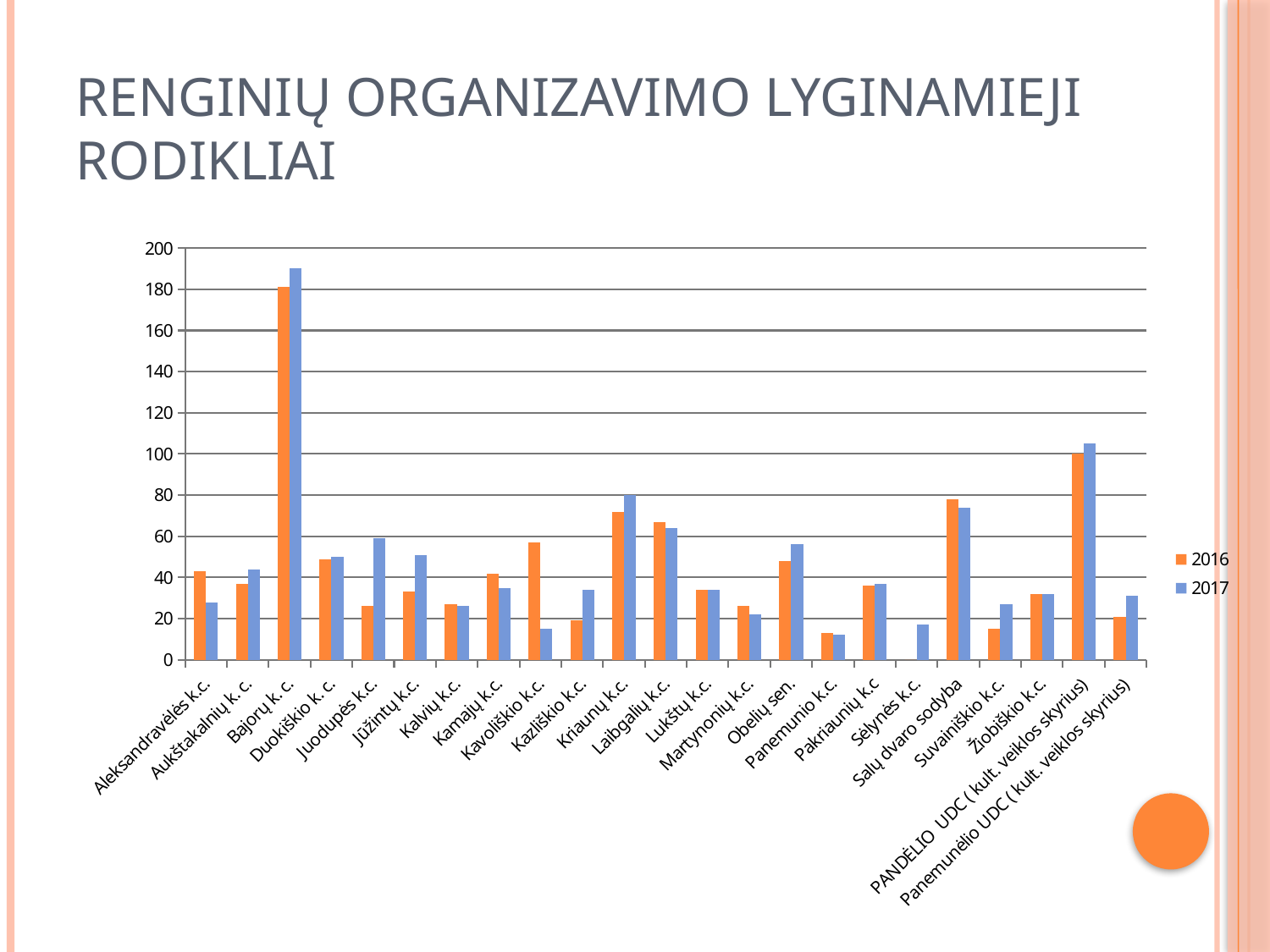
Which category has the highest value for 2016? Bajorų k.c. For Kavoliškio k.c., which series has the larger value, 2016 or 2017? 2016 For Juodupės k.c., which series has the larger value, 2016 or 2017? 2017 How many categories are shown on the x axis? 23 Is the 2017 value for Bajorų k.c. greater or less than 180? greater What kind of chart is shown on the slide? bar chart How many series does the legend list? 2 Which colour represents the 2017 series in the legend? blue Is the 2016 value for Panemunio k.c. greater or less than 20? less Is the 2016 value for Kriaunų k.c. greater or less than 60? greater Which category has the highest value for 2017? Bajorų k.c.